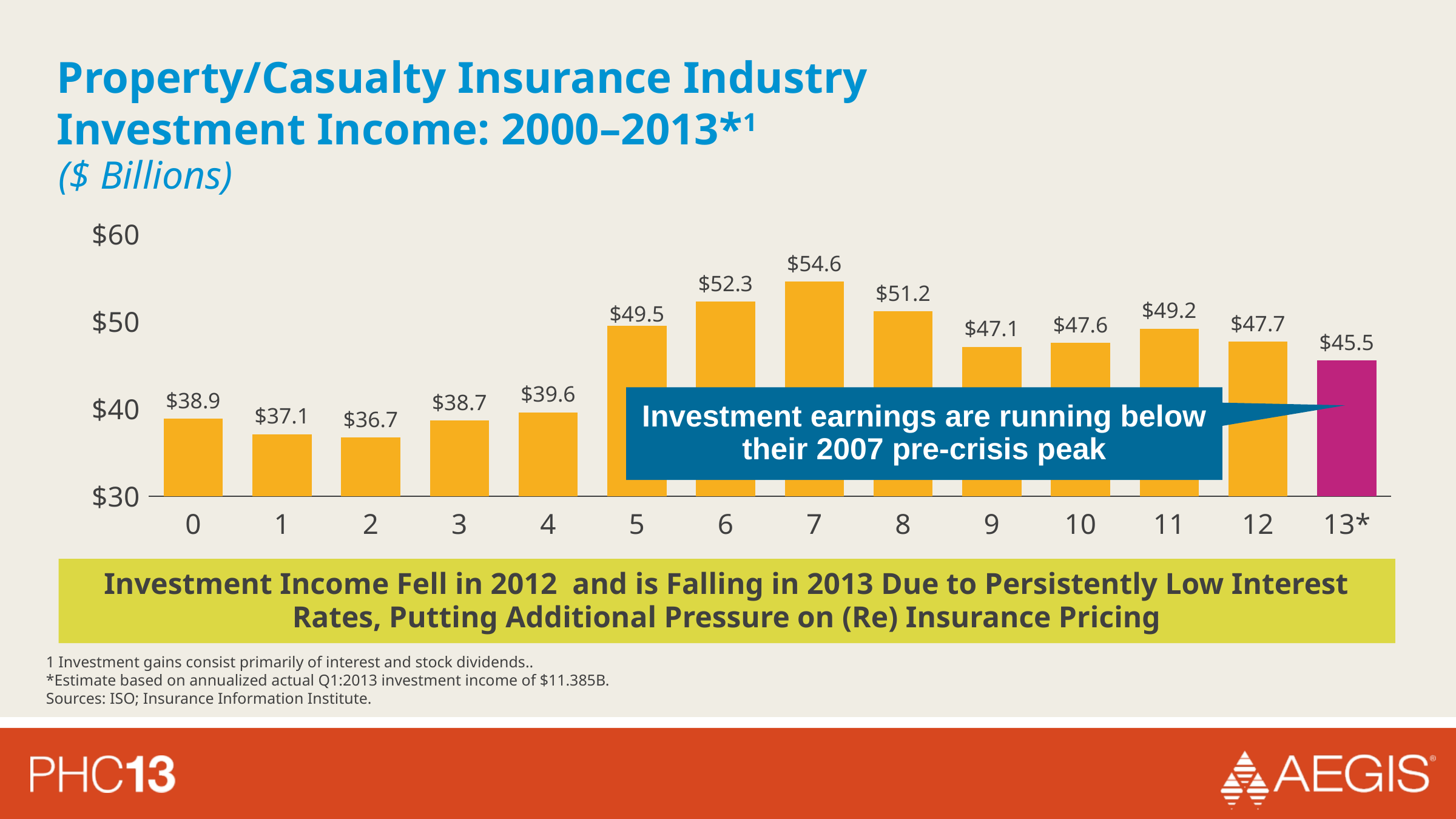
Which x-axis category has the lowest value? 2 What is the value for the bar labelled 13* on the x axis? $45.5 What is the value for the bar labelled 2 on the x axis? $36.7 Which bar is coloured differently (magenta) from the others? 13* What is the difference between the values for categories 12 and 11? $1.5 What kind of chart is shown on the slide? bar chart What is the difference between the values for categories 7 and 13*? $9.1 Which is larger, the value for category 6 or the value for category 8? 6 What is the value for the bar labelled 7 on the x axis? $54.6 Is the value for category 5 greater or less than $40? greater Which x-axis category has the highest value? 7 How many bars are plotted in the chart? 14